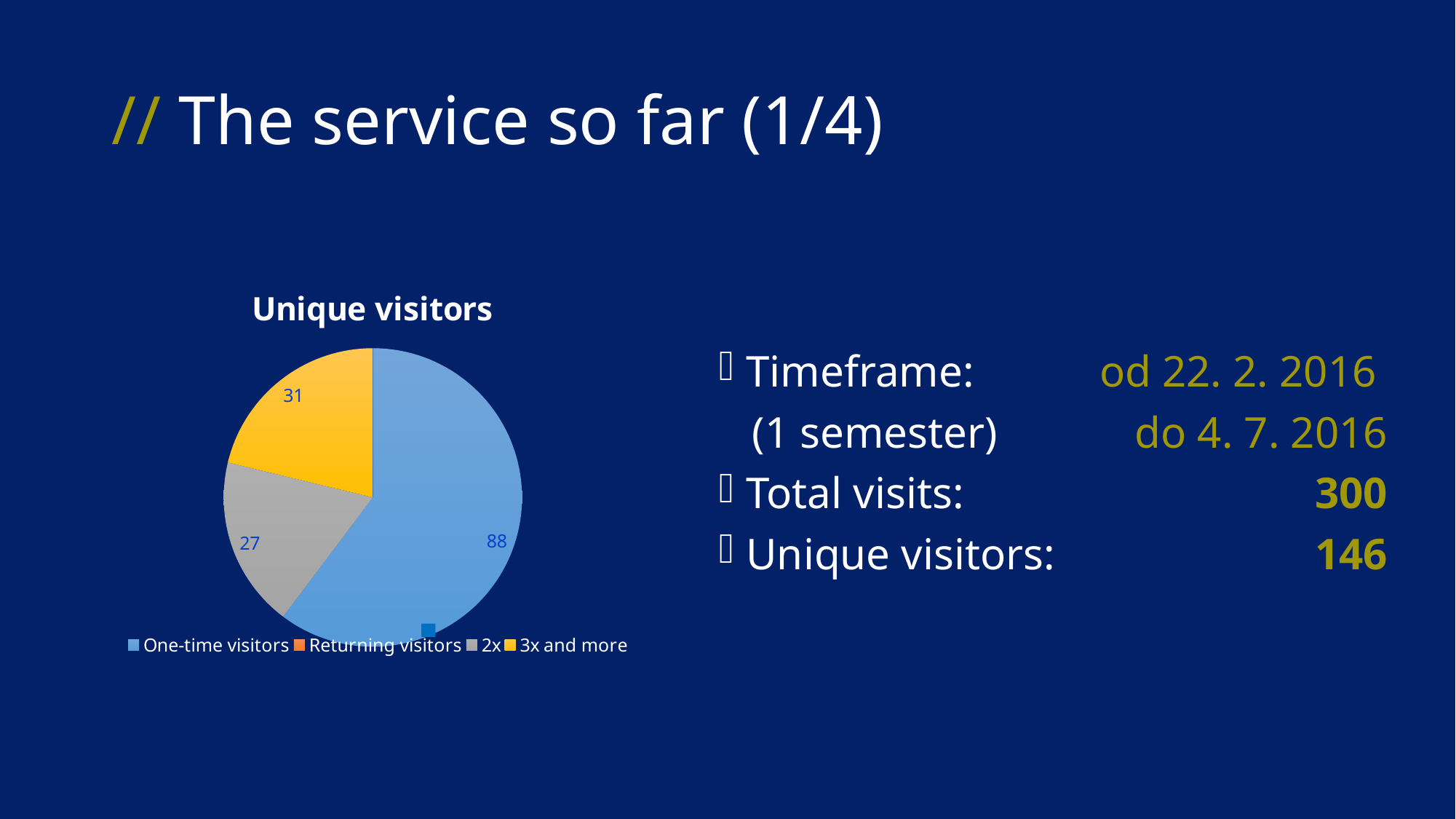
How many entries does the legend of the pie chart list? 4 What is the difference between the 3x and more value and the 2x value in the pie chart? 4 What is the title of the pie chart? Unique visitors Which labelled slice is the smallest in the Unique visitors pie chart? 2x What is the difference between the One-time visitors value and the 3x and more value in the pie chart? 57 What kind of chart is shown on the slide? pie chart Which category has the largest slice in the Unique visitors pie chart? One-time visitors What is the value for the 2x slice in the Unique visitors pie chart? 27 What is the value for One-time visitors in the Unique visitors pie chart? 88 What is the value for the 3x and more slice in the Unique visitors pie chart? 31 What is the difference between the One-time visitors value and the 2x value in the pie chart? 61 Which is larger in the pie chart, the 3x and more slice or the 2x slice? 3x and more